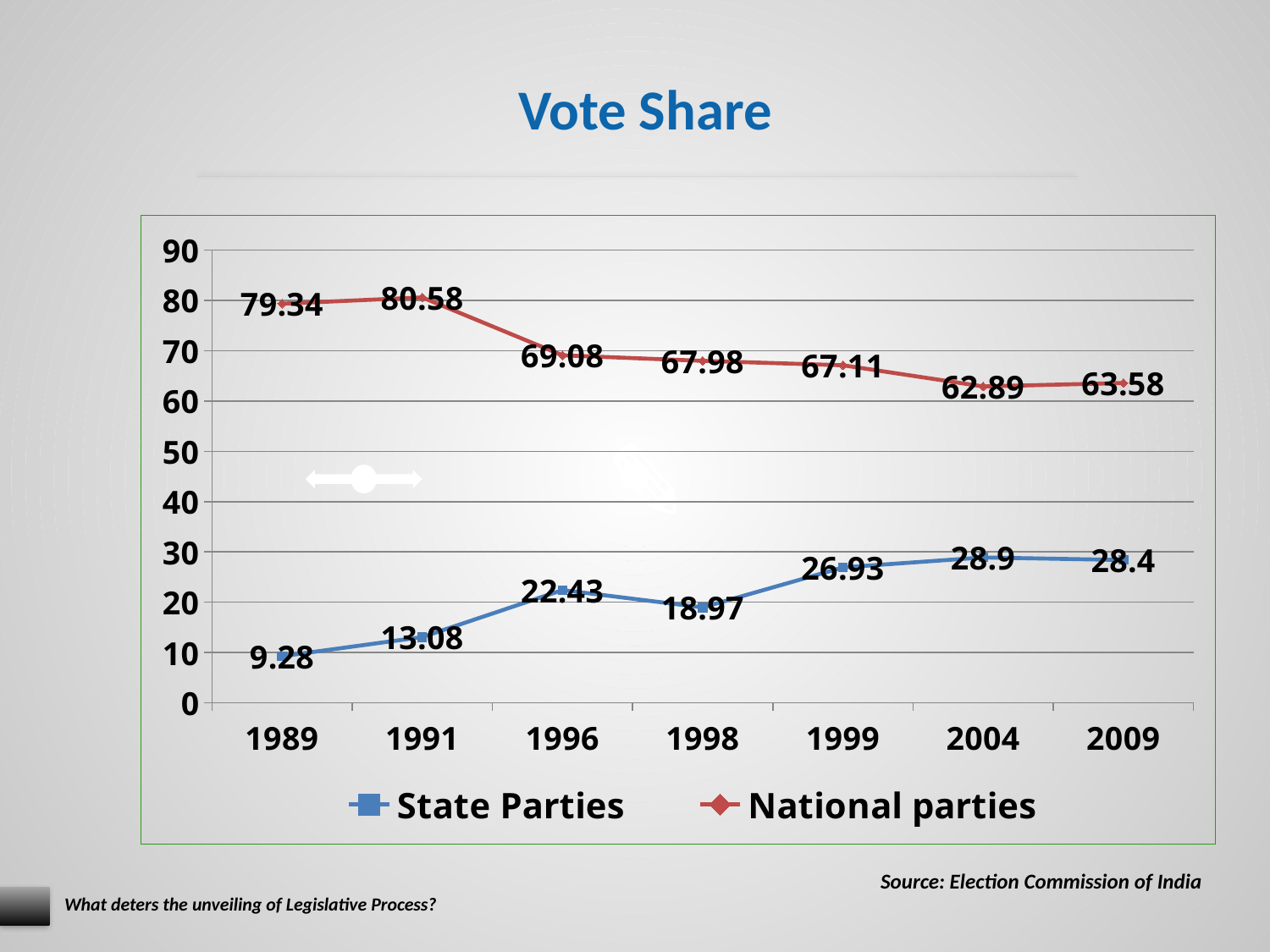
Does the vote share of National parties generally rise or fall from 1991 to 2004? Fall Which series has the larger vote share in 1996, State Parties or National parties? National parties What is the title of the chart? Vote Share In which year did National parties have their highest vote share? 1991 What is the difference between the National parties and State Parties vote shares in 2009? 35.18 What is the vote share of State Parties in 2004? 28.9 How many series does the legend list? 2 How many years are shown on the x axis? 7 What kind of chart is shown on the slide? Line chart What is the vote share of National parties in 1991? 80.58 In which year did State Parties have their lowest vote share? 1989 What is the vote share of State Parties in 1989? 9.28